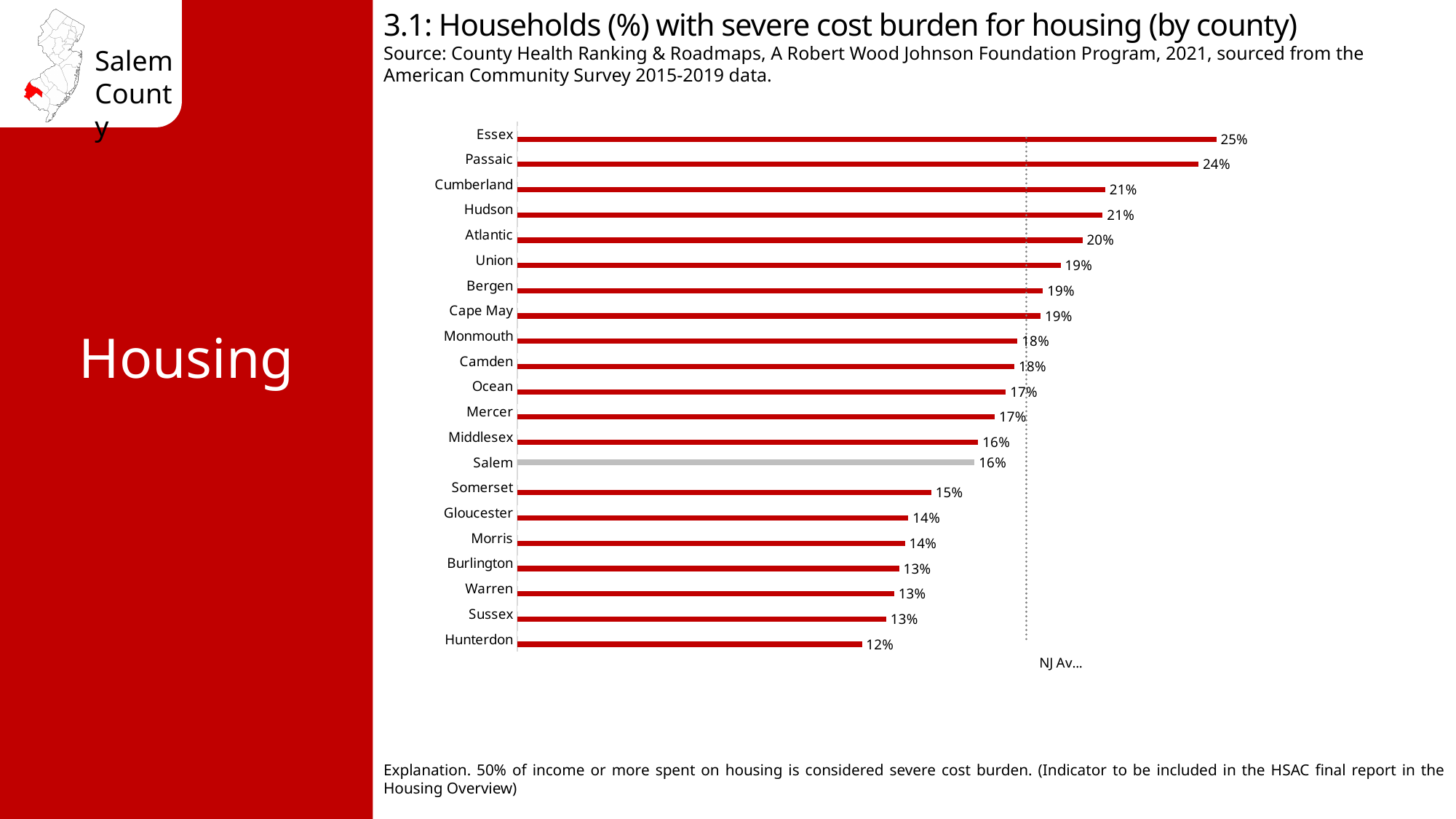
What kind of chart is shown on the slide? Bar chart What is the value for Salem? 16% What is the value for Cumberland? 21% What is the difference between the values for Passaic and Hunterdon? 12% What is the difference between the values for Essex and Salem? 9% Which has a larger value, Atlantic or Somerset? Atlantic Which county has the lowest percentage of households with severe cost burden for housing? Hunterdon What is the value for Hunterdon? 12% How many counties are shown in the chart? 21 Which county has the highest percentage of households with severe cost burden for housing? Essex Which county's bar is shown in grey rather than red? Salem What is the value for Essex? 25%